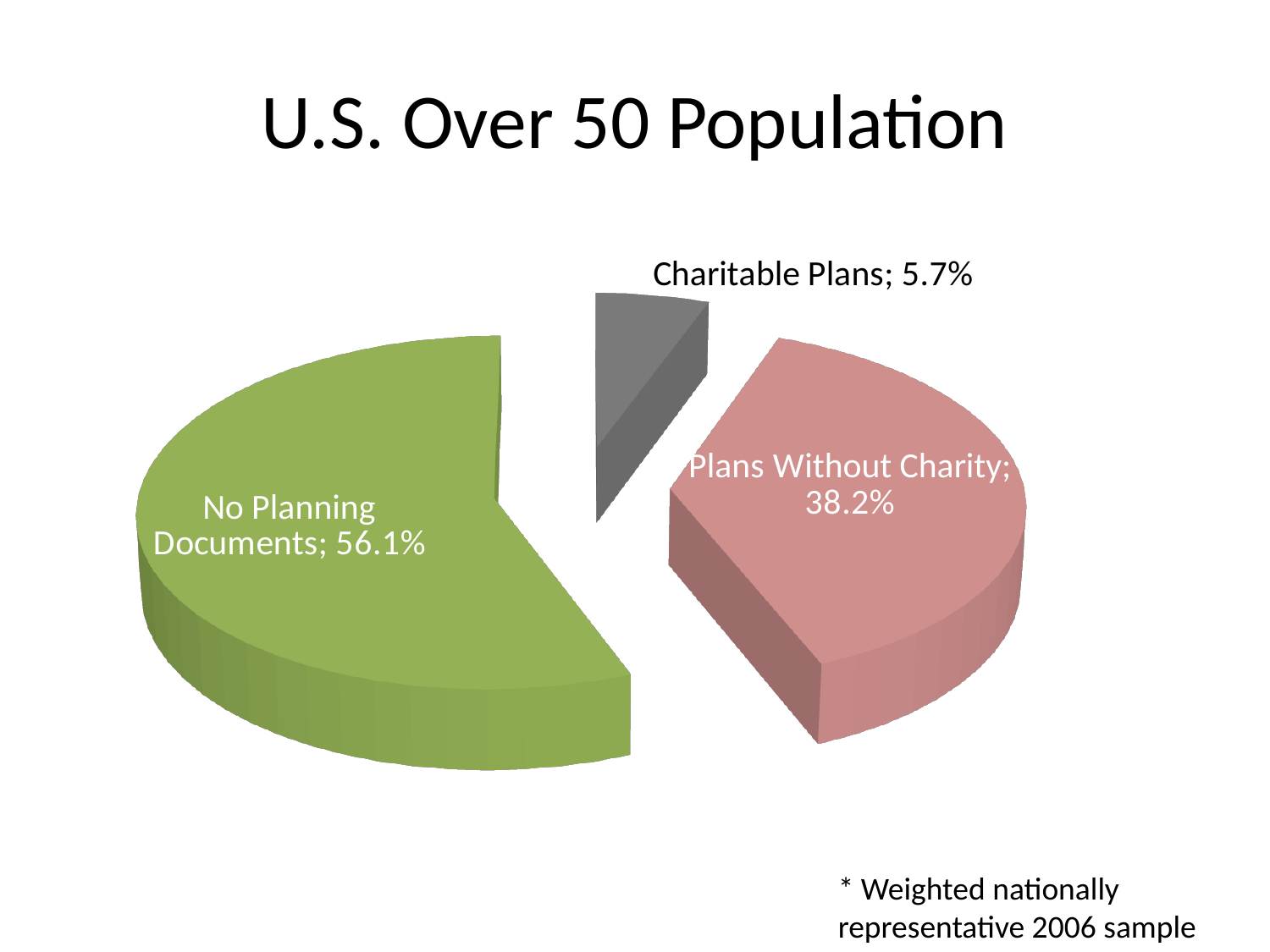
What is the title of the chart? U.S. Over 50 Population What share of the pie is labelled No Planning Documents? 56.1% What share of the pie is labelled Charitable Plans? 5.7% What share of the pie is labelled Plans Without Charity? 38.2% What is the difference in percentage points between Plans Without Charity and Charitable Plans? 32.5 What is the difference in percentage points between No Planning Documents and Plans Without Charity? 17.9 What kind of chart is shown on the slide? pie chart Which slice of the pie is the largest? No Planning Documents Which slice of the pie is the smallest? Charitable Plans Which is larger, the share for Plans Without Charity or the share for Charitable Plans? Plans Without Charity What colour is the No Planning Documents slice? green How many slices does the pie chart have? 3